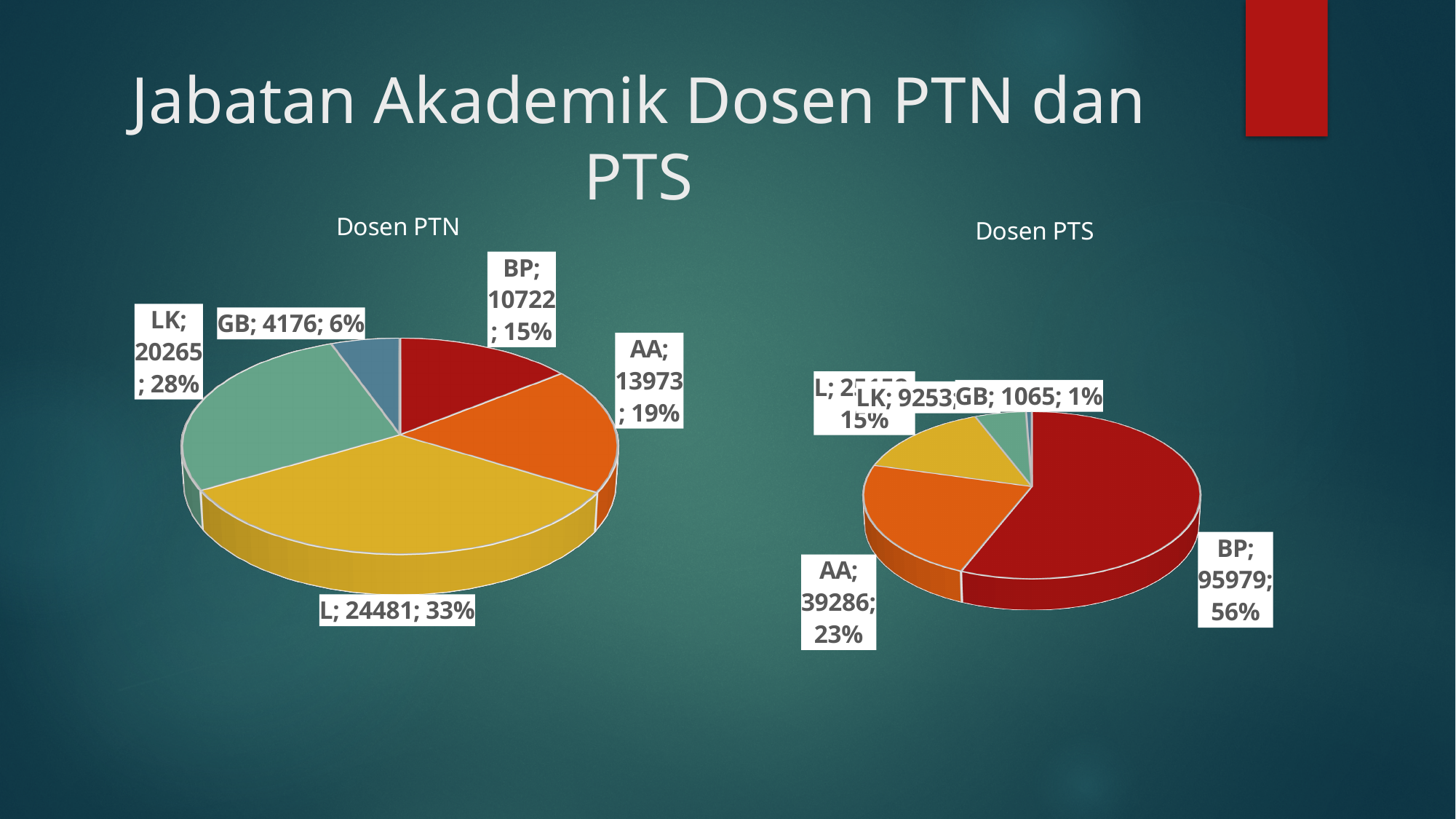
In the Dosen PTS chart, what is the value for BP? 95979 Which is larger: the value for BP in the Dosen PTS chart or the value for BP in the Dosen PTN chart? Dosen PTS In the Dosen PTS chart, which category has the smallest slice? GB In the Dosen PTS chart, what percentage share does AA have? 23% In the Dosen PTN chart, what is the value for L? 24481 In the Dosen PTN chart, which category has the largest slice? L In the Dosen PTN chart, what is the value for GB? 4176 In the Dosen PTN chart, what percentage share does LK have? 28% In the Dosen PTN chart, what is the difference between the values for AA and BP? 3251 In the Dosen PTN chart, which category has the smallest slice? GB What kind of chart is the Dosen PTN chart? Pie chart In the Dosen PTS chart, what is the value for LK? 9253